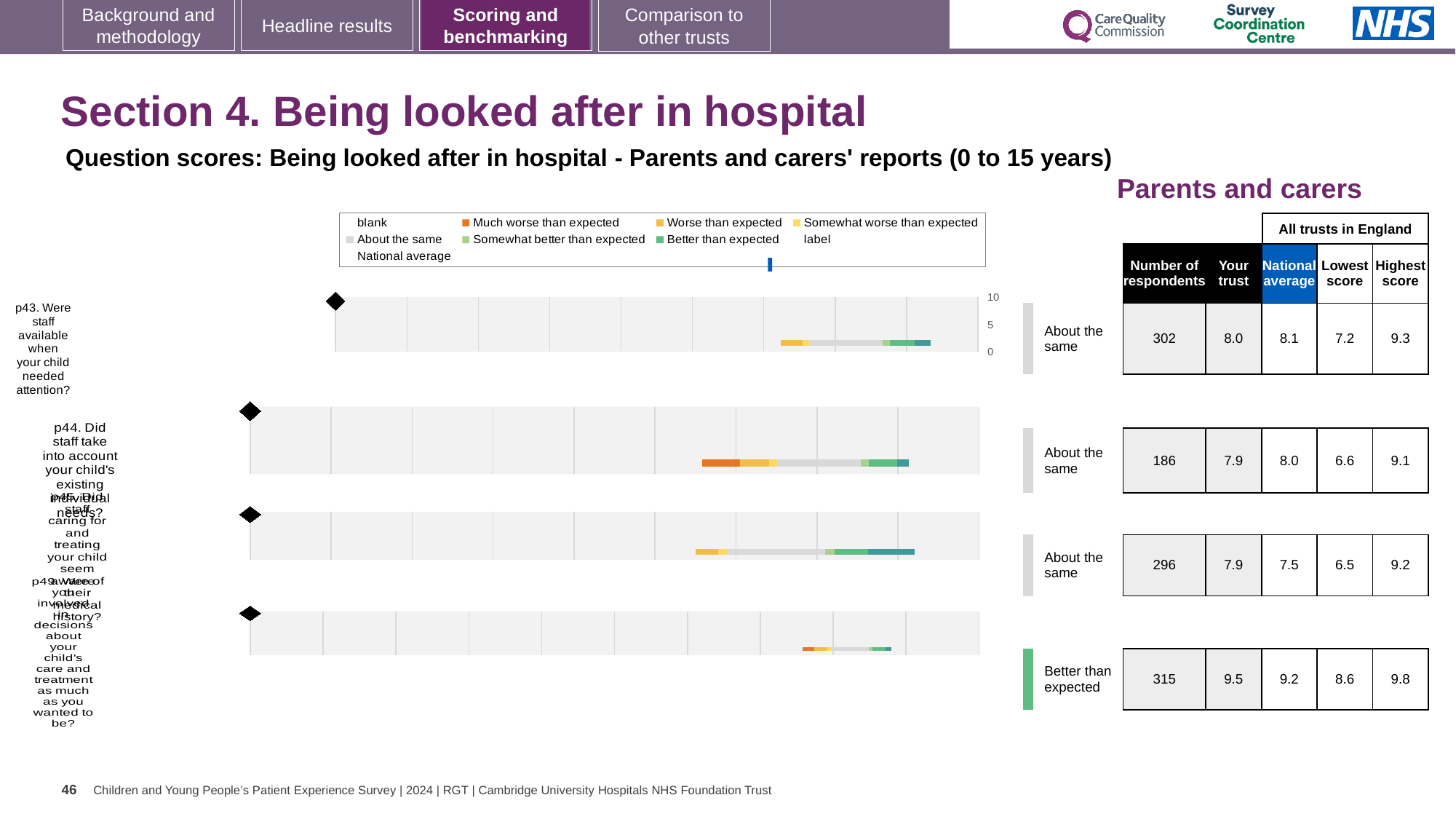
For the first chart (p43), what is the 'Your trust' score? 8.0 For the fourth (bottom) chart, what is the difference between the highest score and the lowest score? 1.2 For the fourth (bottom) chart, what is the 'Your trust' score? 9.5 For the fourth (bottom) chart, what is the highest score among all trusts in England? 9.8 How many question charts (rows) are shown on the slide? 4 For the first chart (p43), what is the national average score? 8.1 What benchmark category label is shown next to the fourth (bottom) chart? Better than expected What kind of chart is used to show the question scores on this slide? bar chart For the first chart (p43, Were staff available when your child needed attention?), what is the number of respondents shown in the table? 302 Which chart row has the lowest 'Lowest score' value? The third row, with 6.5 Which chart row has the highest number of respondents? The fourth (bottom) row, with 315 For the first chart (p43), which is larger: the 'Your trust' score or the national average? National average